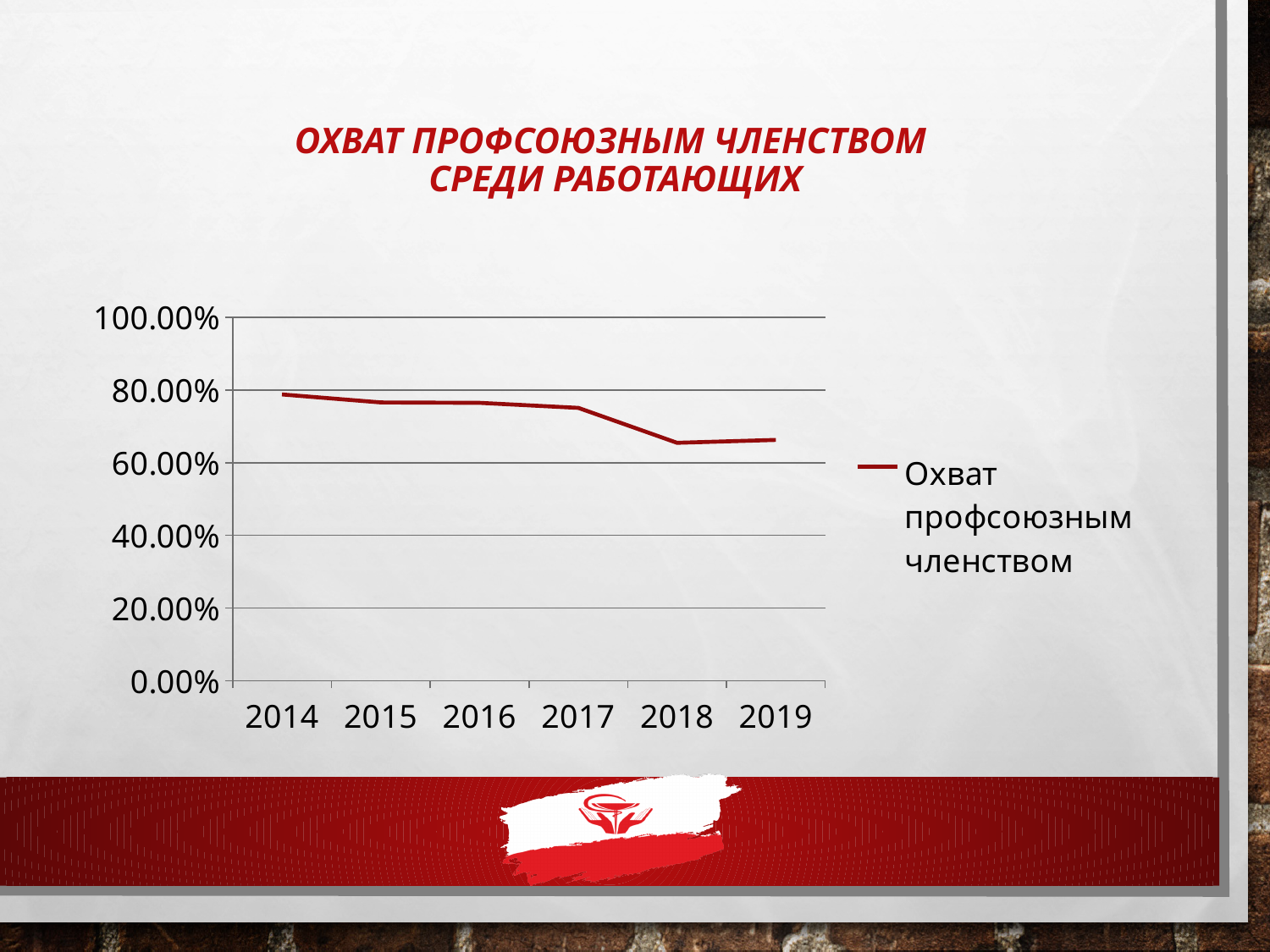
Is the value for 2017 greater or less than 60.00%? greater Which year has the highest value for Охват профсоюзным членством? 2014 How many years are plotted along the x axis? 6 Which is larger, the value for 2017 or the value for 2018? 2017 Do the values generally rise or fall from 2014 to 2019? fall Is the value for 2018 greater or less than 80.00%? less What kind of chart is shown on the slide? line chart How many series does the legend list? 1 Is the value for 2014 greater or less than 60.00%? greater Which is larger, the value for 2014 or the value for 2019? 2014 What is the title of the chart on the slide? ОХВАТ ПРОФСОЮЗНЫМ ЧЛЕНСТВОМ СРЕДИ РАБОТАЮЩИХ What is the name of the series shown in the legend? Охват профсоюзным членством